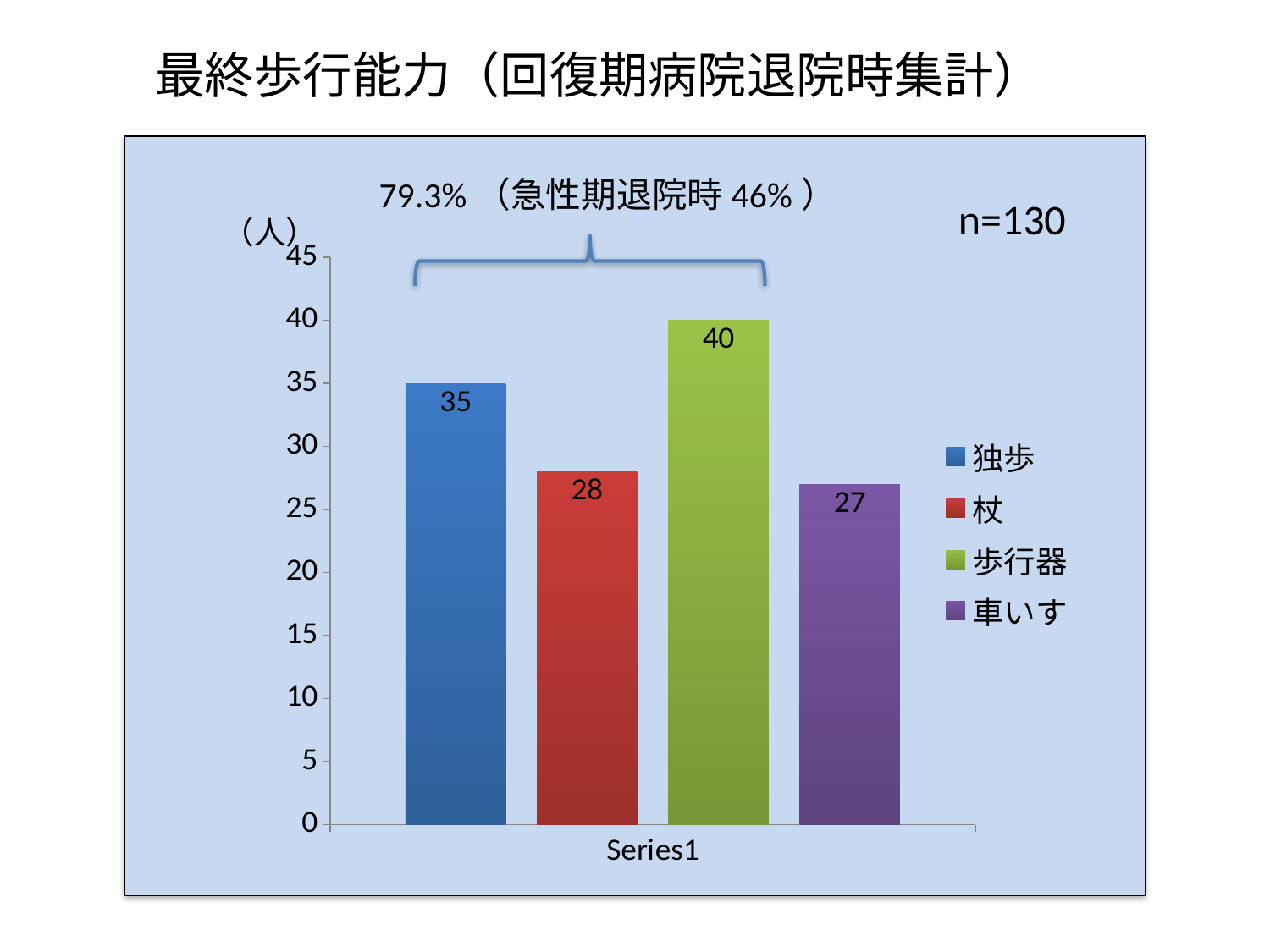
What is the value for 車いす? 27 Which category has the lowest value? 車いす What is the value for 歩行器? 40 What is the difference between the values for 歩行器 and 独歩? 5 What is the sample size (n) shown on the slide? n=130 Which category has the highest value? 歩行器 What is the value for 独歩? 35 What is the value for 杖? 28 How many series does the legend list? 4 What is the title of the slide? 最終歩行能力（回復期病院退院時集計） Which is larger, the value for 独歩 or the value for 杖? 独歩 What kind of chart is shown on the slide? bar chart